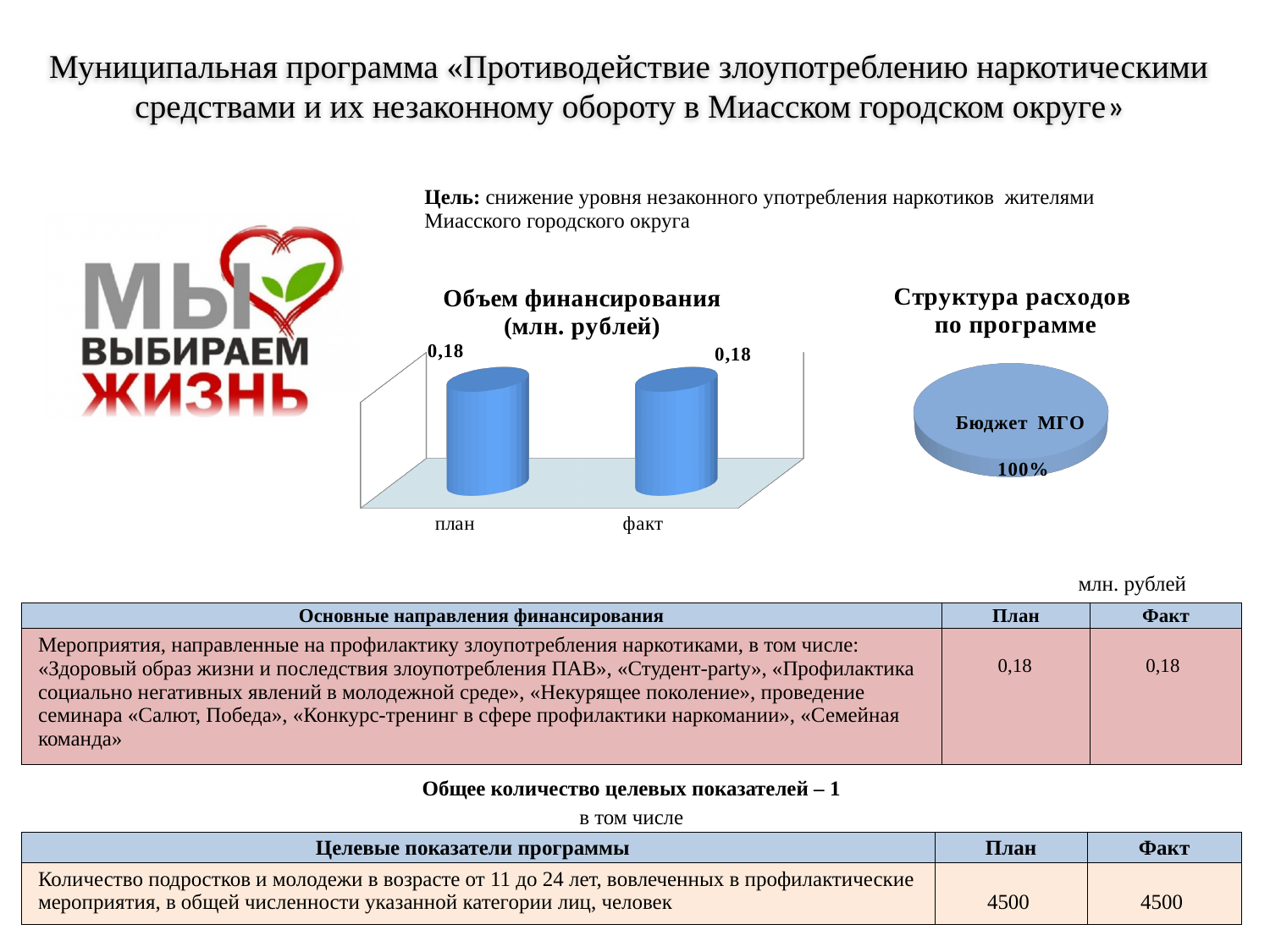
In the chart titled «Структура расходов по программе», what share does «Бюджет МГО» have? 100% In the chart titled «Объем финансирования (млн. рублей)», what is the value for факт? 0,18 In the chart titled «Объем финансирования (млн. рублей)», what are the two category labels on the x axis? план, факт In the chart titled «Объем финансирования (млн. рублей)», how many categories are plotted? 2 In the chart titled «Объем финансирования (млн. рублей)», what is the difference between the план and факт values? 0 What kind of chart is the one titled «Объем финансирования (млн. рублей)»? bar chart In the chart titled «Структура расходов по программе», what is the label of the only slice? Бюджет МГО In the chart titled «Объем финансирования (млн. рублей)», what is the value for план? 0,18 In the chart titled «Структура расходов по программе», how many slices does the pie have? 1 How many charts are shown on the slide? 2 What kind of chart is the one titled «Структура расходов по программе»? pie chart